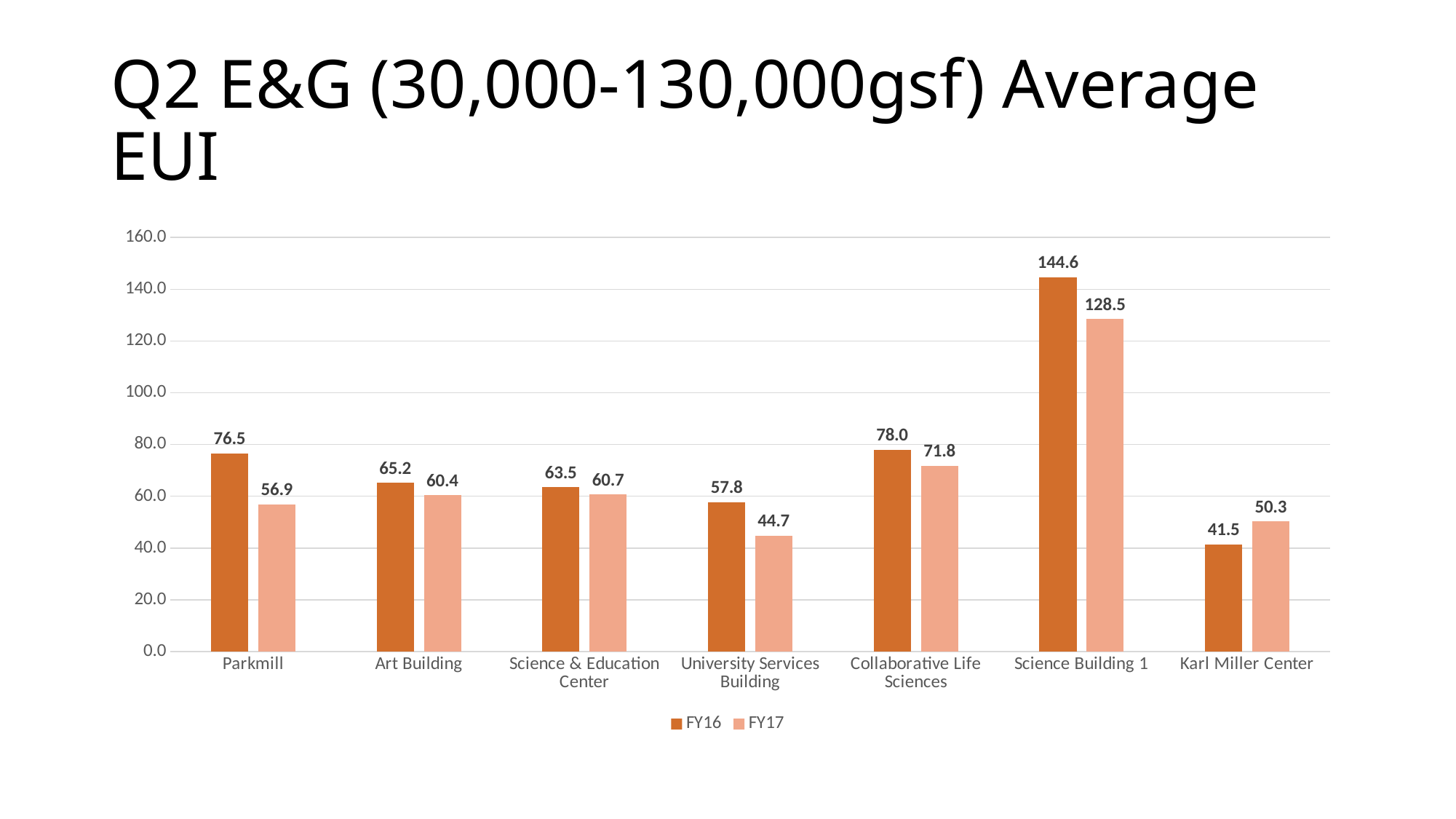
Which building has the highest FY16 value? Science Building 1 What kind of chart is shown on the slide? bar chart What is the FY17 value for University Services Building? 44.7 Which building has the lowest FY17 value? University Services Building What is the FY16 value for Parkmill? 76.5 How many series does the legend list? 2 How many buildings are shown on the x axis? 7 What is the difference between the FY16 and FY17 values for Science Building 1? 16.1 What are the two series named in the legend? FY16 and FY17 Which is larger for Karl Miller Center, the FY16 value or the FY17 value? FY17 Is the FY16 value for Collaborative Life Sciences greater or less than 100.0? less What is the FY17 value for Science Building 1? 128.5